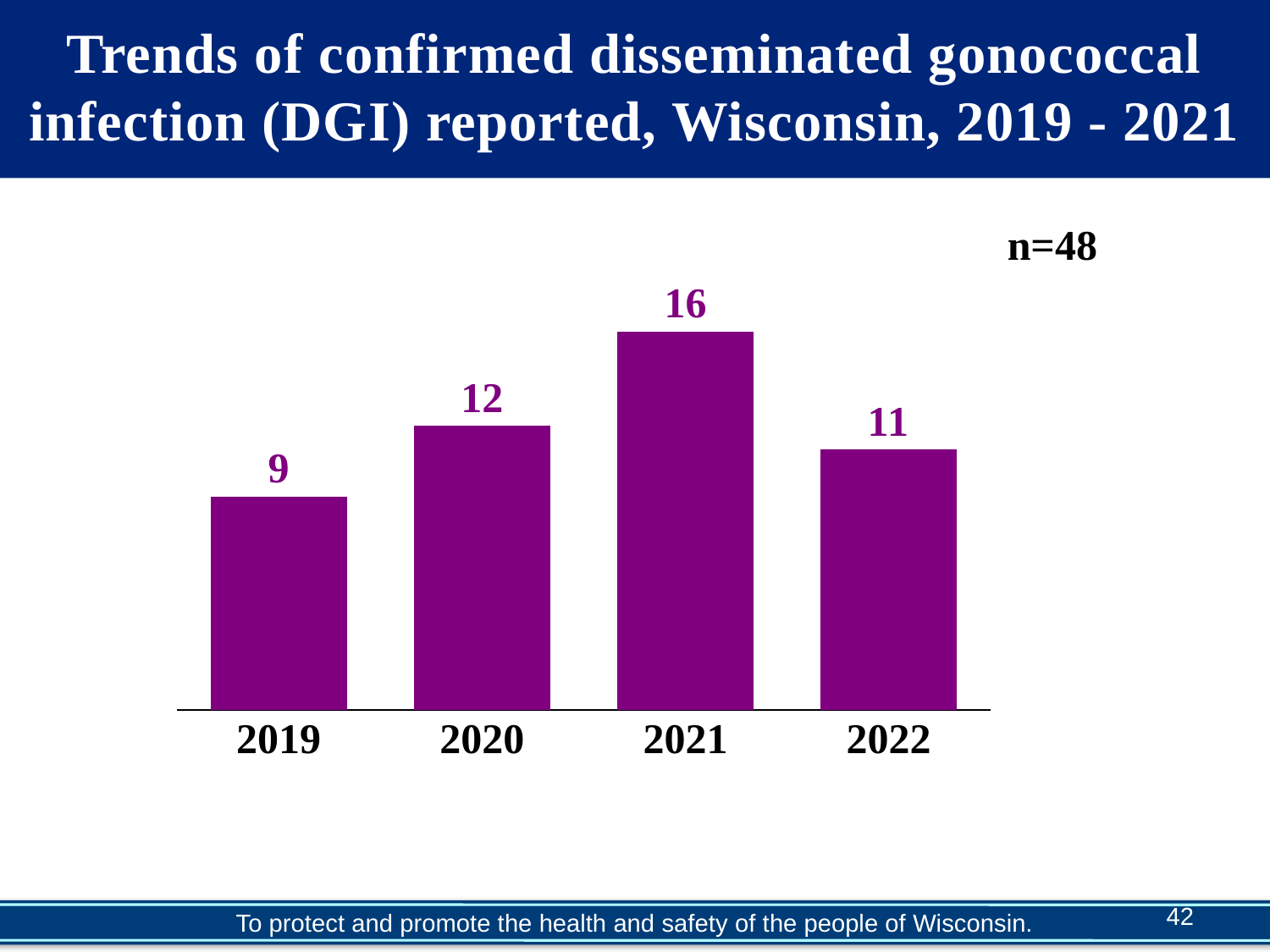
What is the number of confirmed DGI cases reported in 2021? 16 What is the difference between the number of cases in 2021 and 2019? 7 What total sample size (n) is shown on the slide? n=48 What is the number of confirmed DGI cases reported in 2019? 9 Which year has the lowest number of confirmed DGI cases? 2019 Which year had more confirmed DGI cases, 2020 or 2022? 2020 What is the number of confirmed DGI cases reported in 2022? 11 What is the difference between the number of cases in 2020 and 2022? 1 What kind of chart is shown on the slide? Bar chart Which year has the highest number of confirmed DGI cases? 2021 How many years are shown on the x axis of the chart? 4 What is the number of confirmed DGI cases reported in 2020? 12